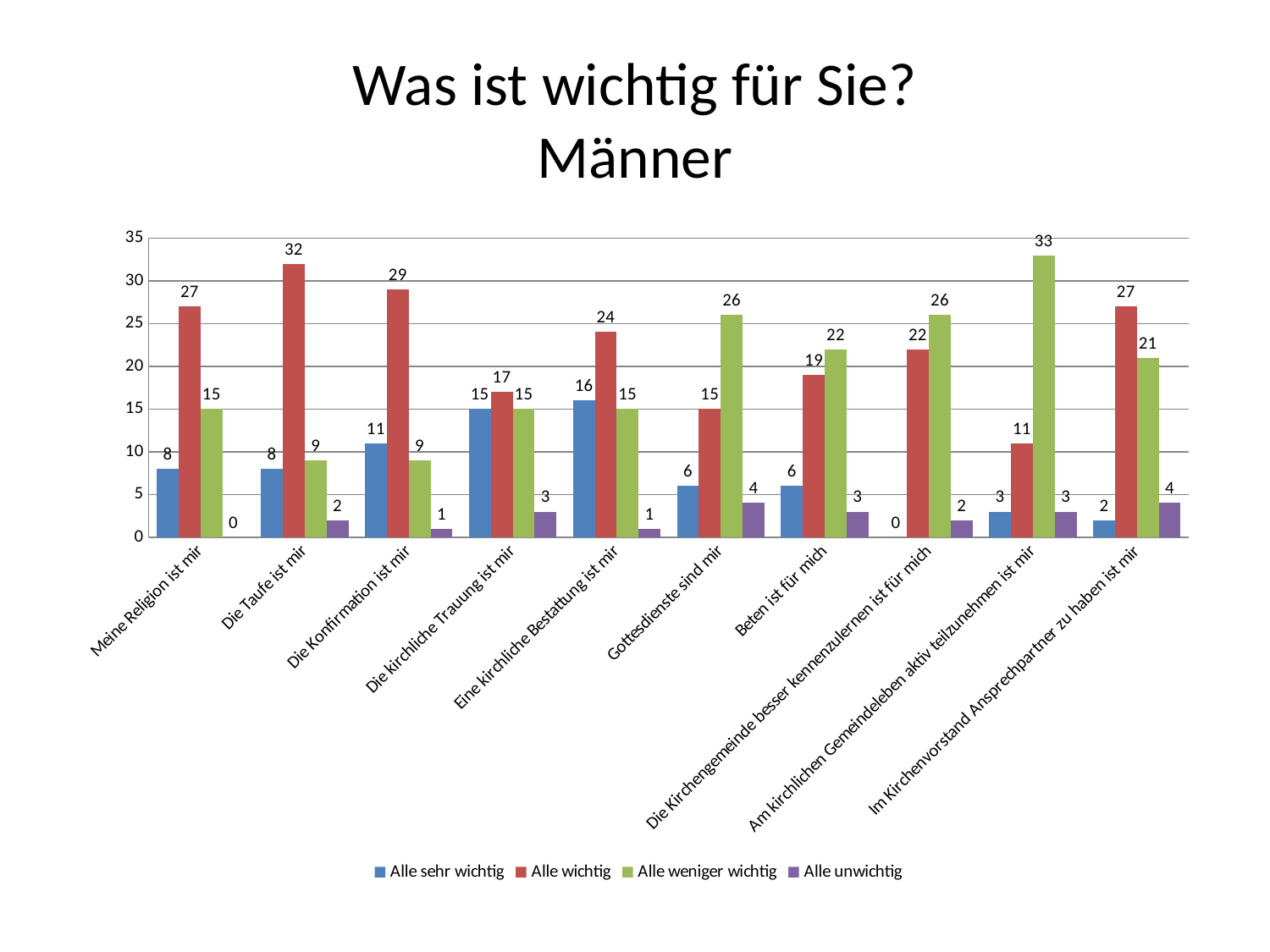
Which is larger for "Beten ist für mich": "Alle wichtig" or "Alle weniger wichtig"? Alle weniger wichtig Which category has the highest value for "Alle wichtig"? Die Taufe ist mir What is the value of "Alle unwichtig" for "Meine Religion ist mir"? 0 Which category has the lowest value for "Alle sehr wichtig"? Die Kirchengemeinde besser kennenzulernen ist für mich How many series does the legend list? 4 What is the value of "Alle wichtig" for "Die Taufe ist mir"? 32 What kind of chart is shown on the slide? Bar chart How many categories are shown on the x axis? 10 What is the title of the chart on the slide? Was ist wichtig für Sie? Männer What is the value of "Alle weniger wichtig" for "Am kirchlichen Gemeindeleben aktiv teilzunehmen ist mir"? 33 What is the difference between "Alle wichtig" and "Alle sehr wichtig" for "Die Konfirmation ist mir"? 18 What is the value of "Alle sehr wichtig" for "Eine kirchliche Bestattung ist mir"? 16